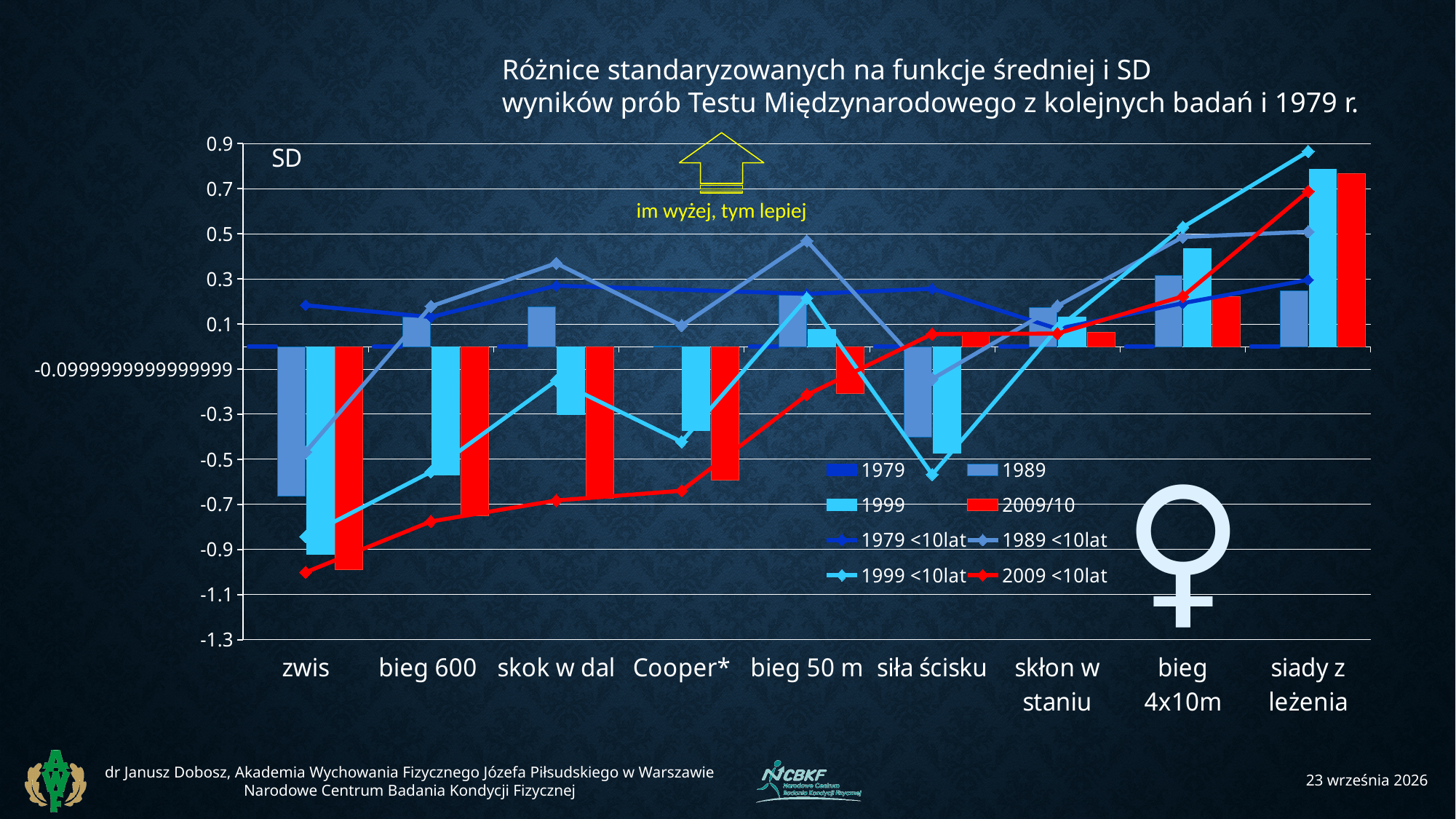
How many categories are shown on the x axis of the chart? 9 What kind of chart is shown on the slide? Combined bar and line chart Which category has the highest 2009/10 bar? siady z leżenia For bieg 4x10m, which is larger: the 1999 bar or the 2009/10 bar? 1999 Which category has the lowest 2009/10 bar? zwis Is the 2009/10 value for zwis greater or less than -0.9? less Is the 2009/10 value for Cooper* greater or less than -0.5? less Is the 1999 value for bieg 4x10m greater or less than 0.3? greater How many series does the chart's legend list? 8 Does the 2009 <10lat line generally rise or fall from zwis to siady z leżenia? rise What does the yellow annotation under the arrow say? im wyżej, tym lepiej Which category has the lowest 1999 bar? zwis